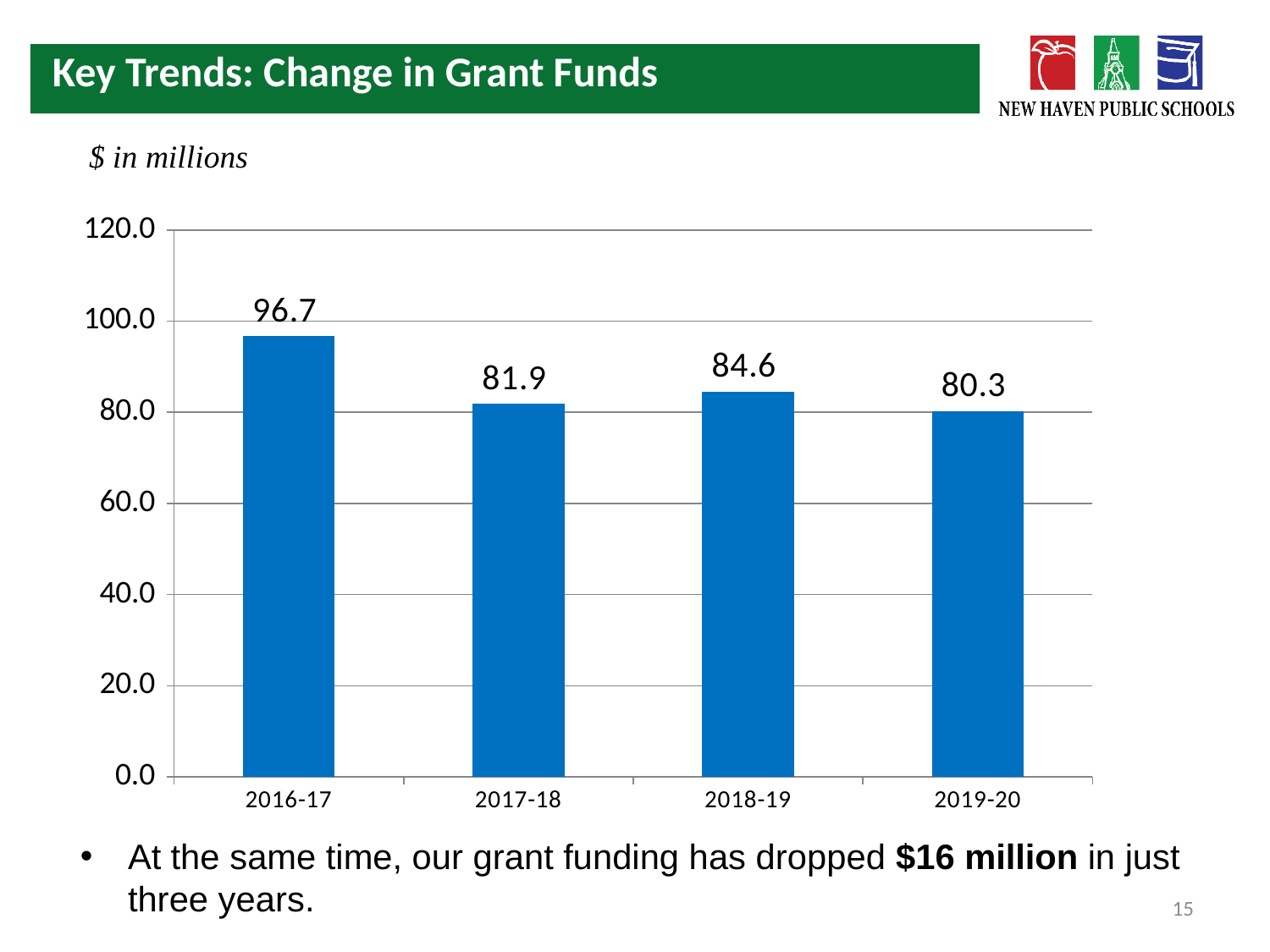
What is the grant funding value for 2019-20? 80.3 What is the grant funding value for 2018-19? 84.6 How many years are shown on the chart? 4 What is the grant funding value for 2016-17? 96.7 What is the grant funding value for 2017-18? 81.9 Which is larger, the grant funding in 2017-18 or 2018-19? 2018-19 What kind of chart is shown on the slide? bar chart What is the difference between the grant funding in 2016-17 and 2019-20? 16.4 Which year has the lowest grant funding? 2019-20 What unit is indicated above the chart? $ in millions Which year has the highest grant funding? 2016-17 Is the value for 2016-17 greater or less than 100.0? less